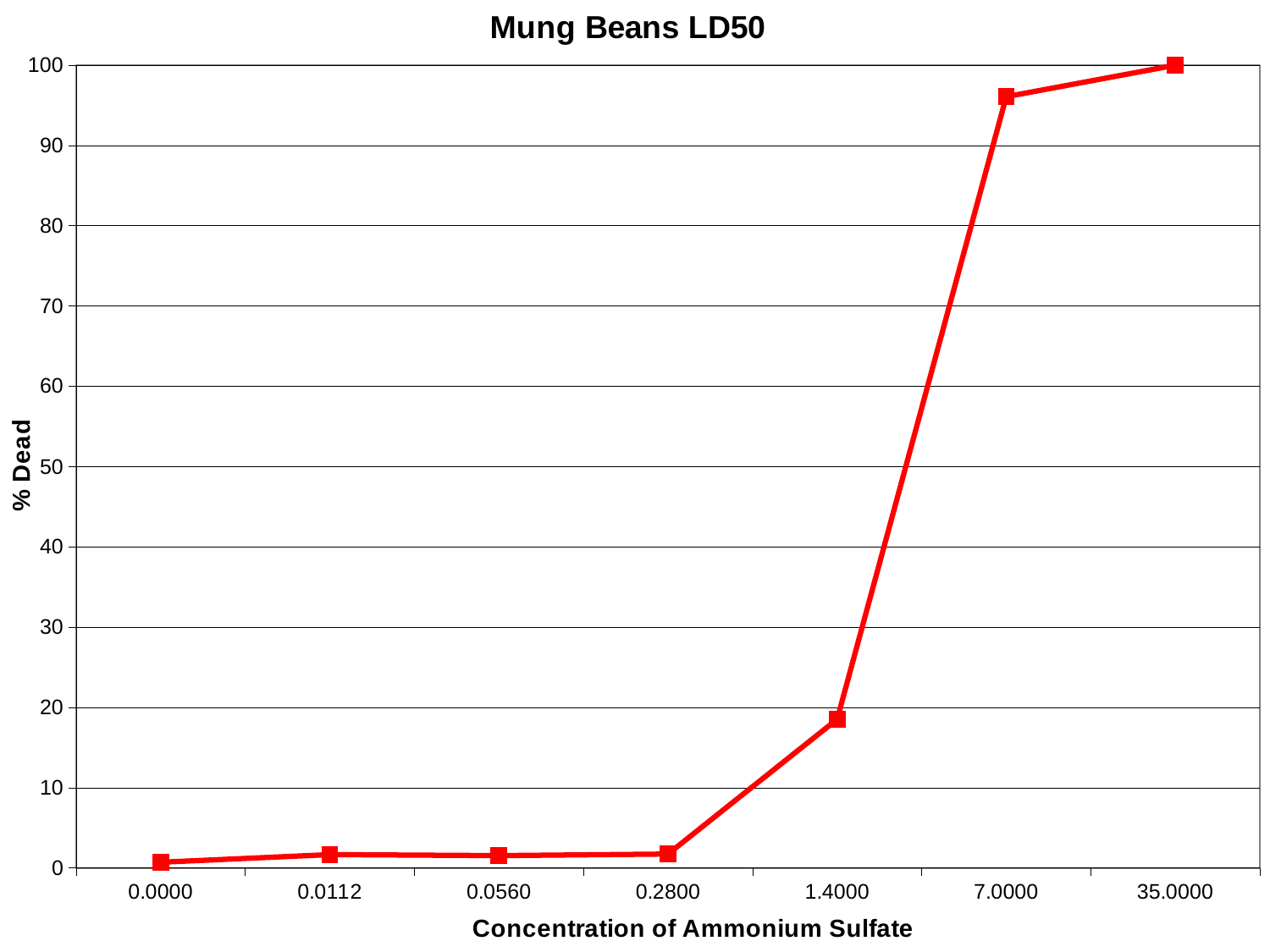
Is the % dead at a concentration of 7.0000 greater or less than 90? greater Which concentration of ammonium sulfate has the lowest % dead? 0.0000 Is the % dead at a concentration of 0.2800 greater or less than 10? less What is the % dead at a concentration of 35.0000? 100 Does the % dead generally rise or fall as the concentration of ammonium sulfate increases? rise Which concentration of ammonium sulfate has the highest % dead? 35.0000 What is the title of the chart? Mung Beans LD50 How many data points are plotted on the chart? 7 What is the label on the y axis? % Dead Is the % dead at a concentration of 1.4000 greater or less than 20? less Which has a higher % dead: a concentration of 1.4000 or 7.0000? 7.0000 What kind of chart is shown on the slide? line chart